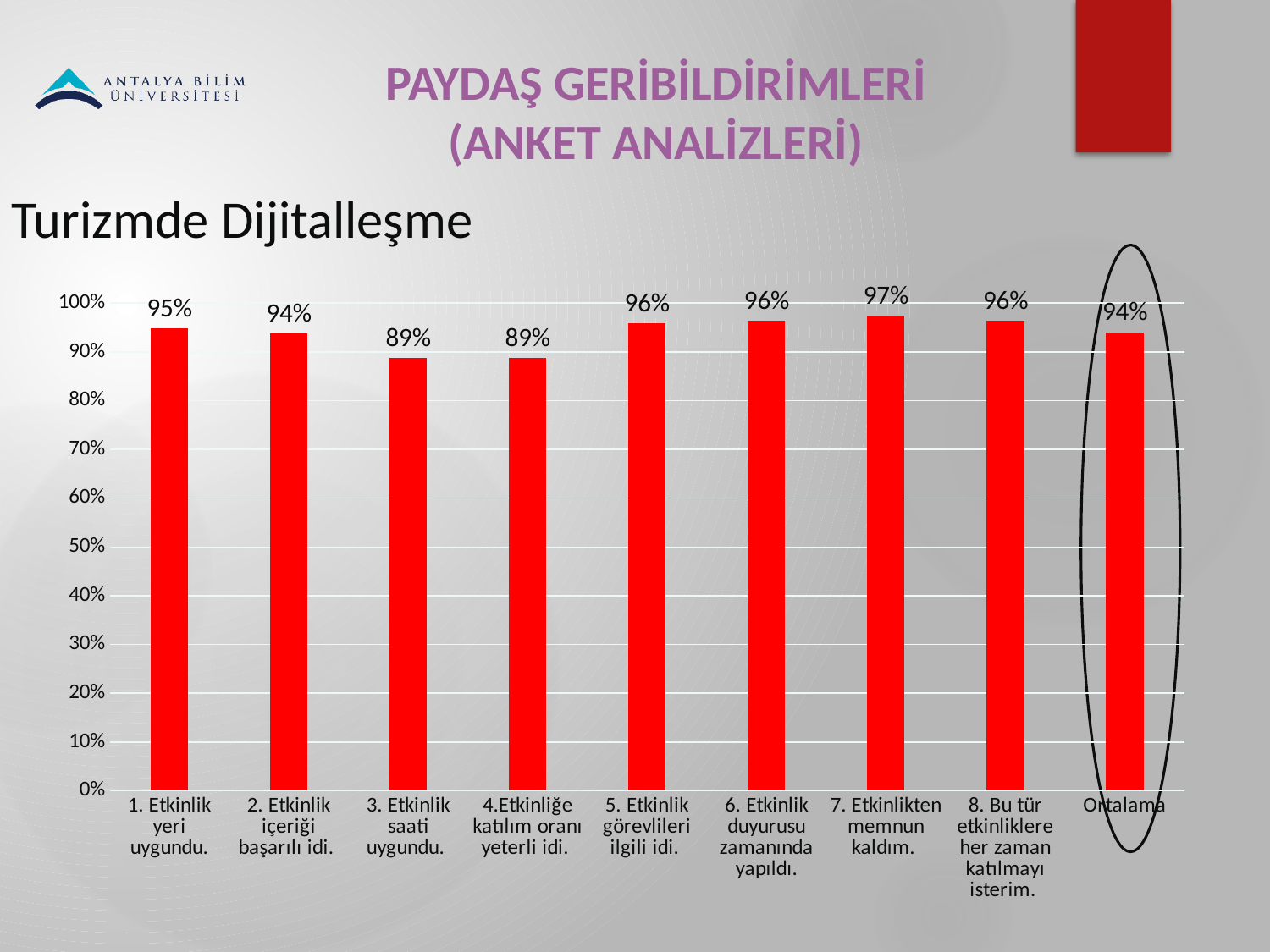
What is the difference between the value for "7. Etkinlikten memnun kaldım." and the value for "4.Etkinliğe katılım oranı yeterli idi."? 8% Which is larger: the value for "1. Etkinlik yeri uygundu." or the value for "2. Etkinlik içeriği başarılı idi."? 1. Etkinlik yeri uygundu. What is the value for "3. Etkinlik saati uygundu."? 89% What is the value shown for "Ortalama"? 94% How many bars are shown in the chart? 9 What is the value for "1. Etkinlik yeri uygundu."? 95% What is the value for "7. Etkinlikten memnun kaldım."? 97% What is the title of the chart? Turizmde Dijitalleşme What is the lowest value shown in the chart? 89% Which category has the highest value? 7. Etkinlikten memnun kaldım. What type of chart is shown on the slide? bar chart Is the value for "3. Etkinlik saati uygundu." greater or less than 90%? less